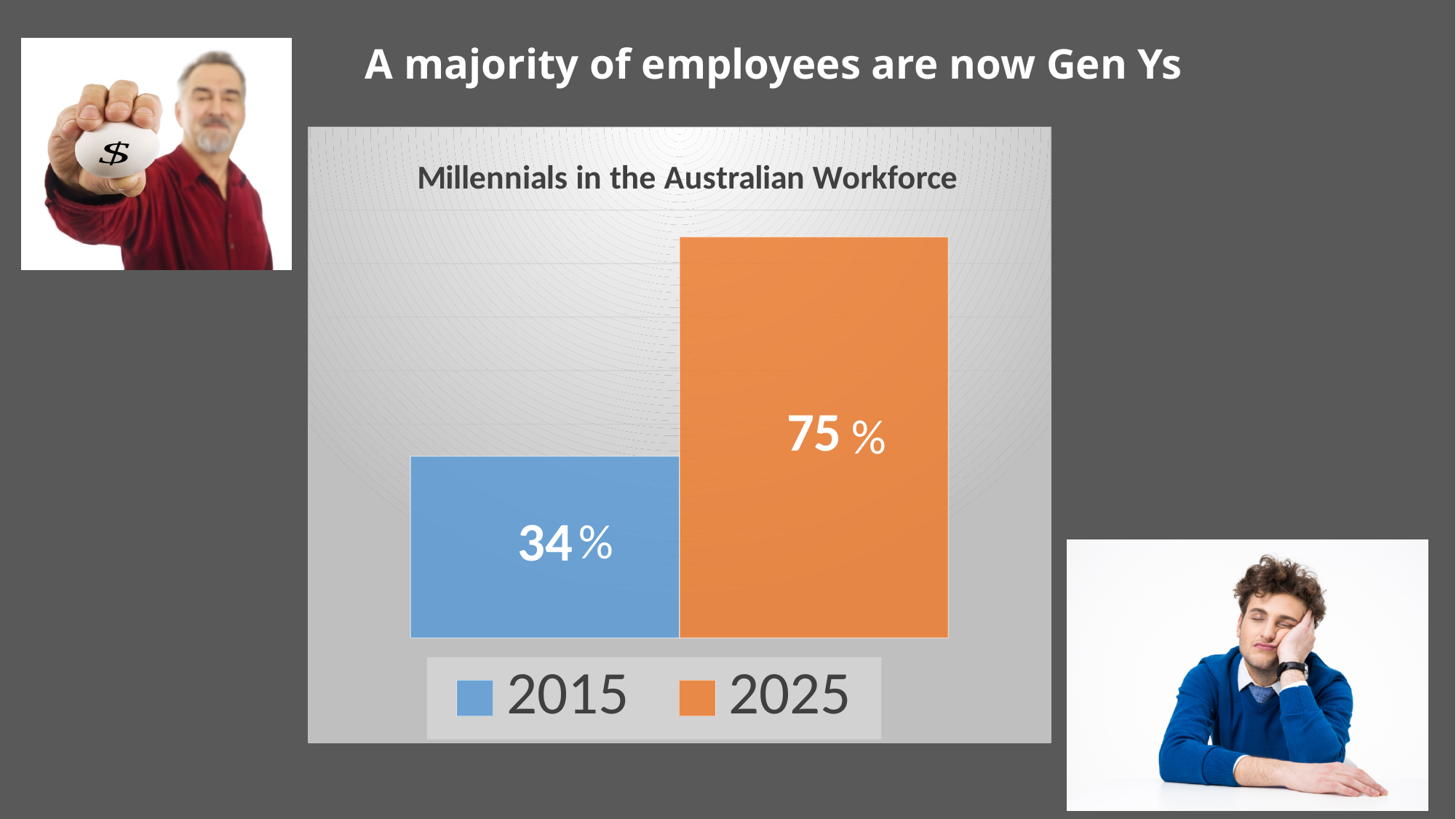
Which series has the lowest value in the chart? 2015 What is the title of the chart? Millennials in the Australian Workforce How many bars are plotted in the chart? 2 How many series does the legend list? 2 What is the difference between the 2025 value and the 2015 value? 41% What colour is the bar for 2025? Orange What is the value for 2015 in the Millennials in the Australian Workforce chart? 34% What is the value for 2025 in the Millennials in the Australian Workforce chart? 75% What kind of chart is shown on the slide? Bar chart Which series has the higher value, 2015 or 2025? 2025 Which series has the highest value in the chart? 2025 Do the values rise or fall from 2015 to 2025? Rise